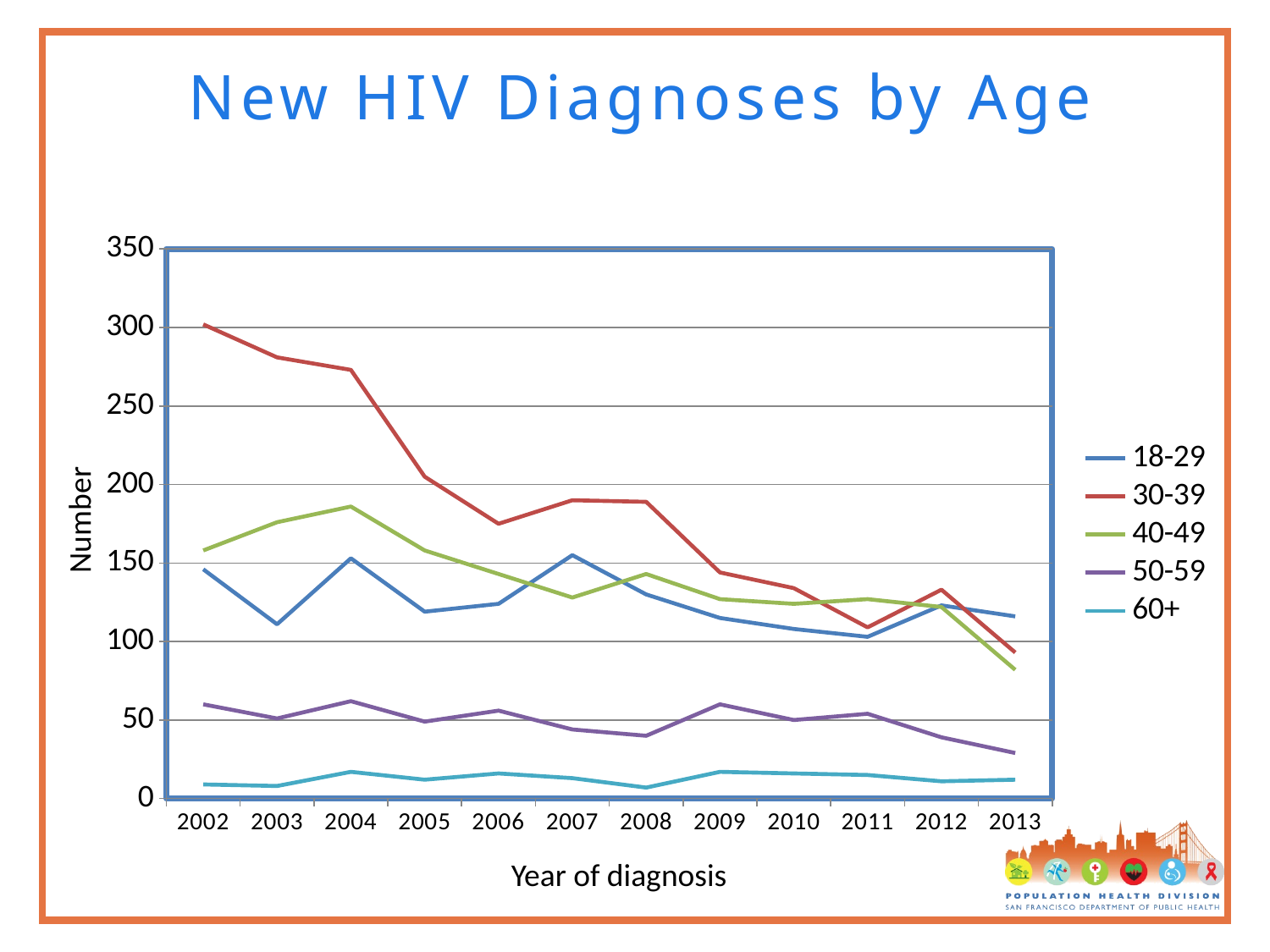
What is the label of the x axis? Year of diagnosis In 2013, which age group had more new diagnoses, 18-29 or 40-49? 18-29 Which age group had the highest number of new diagnoses in 2002? 30-39 How many years are shown along the x axis? 12 What kind of chart is shown on the slide? line chart What is the title of the chart? New HIV Diagnoses by Age Is the value for the 30-39 age group in 2002 greater or less than 250? greater Is the value for the 60+ age group in 2004 greater or less than 50? less Which age group had the lowest number of new diagnoses in 2013? 60+ Is the value for the 50-59 age group in 2013 greater or less than 50? less Does the number of new diagnoses for the 30-39 age group rise or fall from 2002 to 2013? fall How many age groups does the legend list? 5